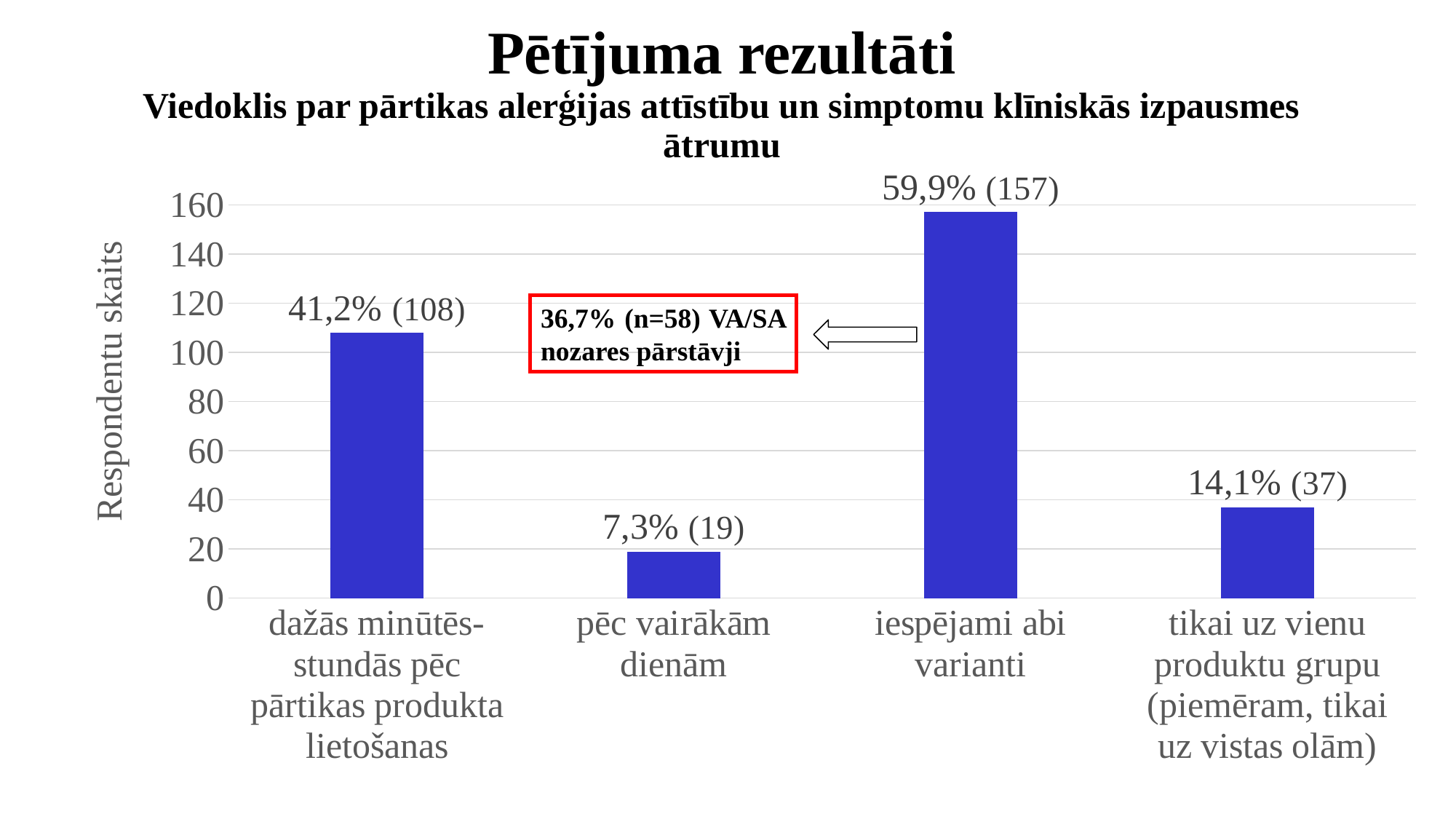
What is the data label shown for the bar 'iespējami abi varianti'? 59,9% (157) Is the value for 'dažās minūtēs-stundās pēc pārtikas produkta lietošanas' greater or less than 100? greater Which category has the highest number of respondents? iespējami abi varianti How many categories are shown on the x axis? 4 How many respondents chose 'tikai uz vienu produktu grupu (piemēram, tikai uz vistas olām)'? 37 What percentage is shown for 'dažās minūtēs-stundās pēc pārtikas produkta lietošanas'? 41,2% What kind of chart is shown on the slide? bar chart Which category has the lowest number of respondents? pēc vairākām dienām Which has more respondents: 'pēc vairākām dienām' or 'tikai uz vienu produktu grupu (piemēram, tikai uz vistas olām)'? tikai uz vienu produktu grupu (piemēram, tikai uz vistas olām) What is the data label shown for the bar 'pēc vairākām dienām'? 7,3% (19) What is the label of the vertical axis? Respondentu skaits What is the difference in respondent count between 'iespējami abi varianti' and 'dažās minūtēs-stundās pēc pārtikas produkta lietošanas'? 49